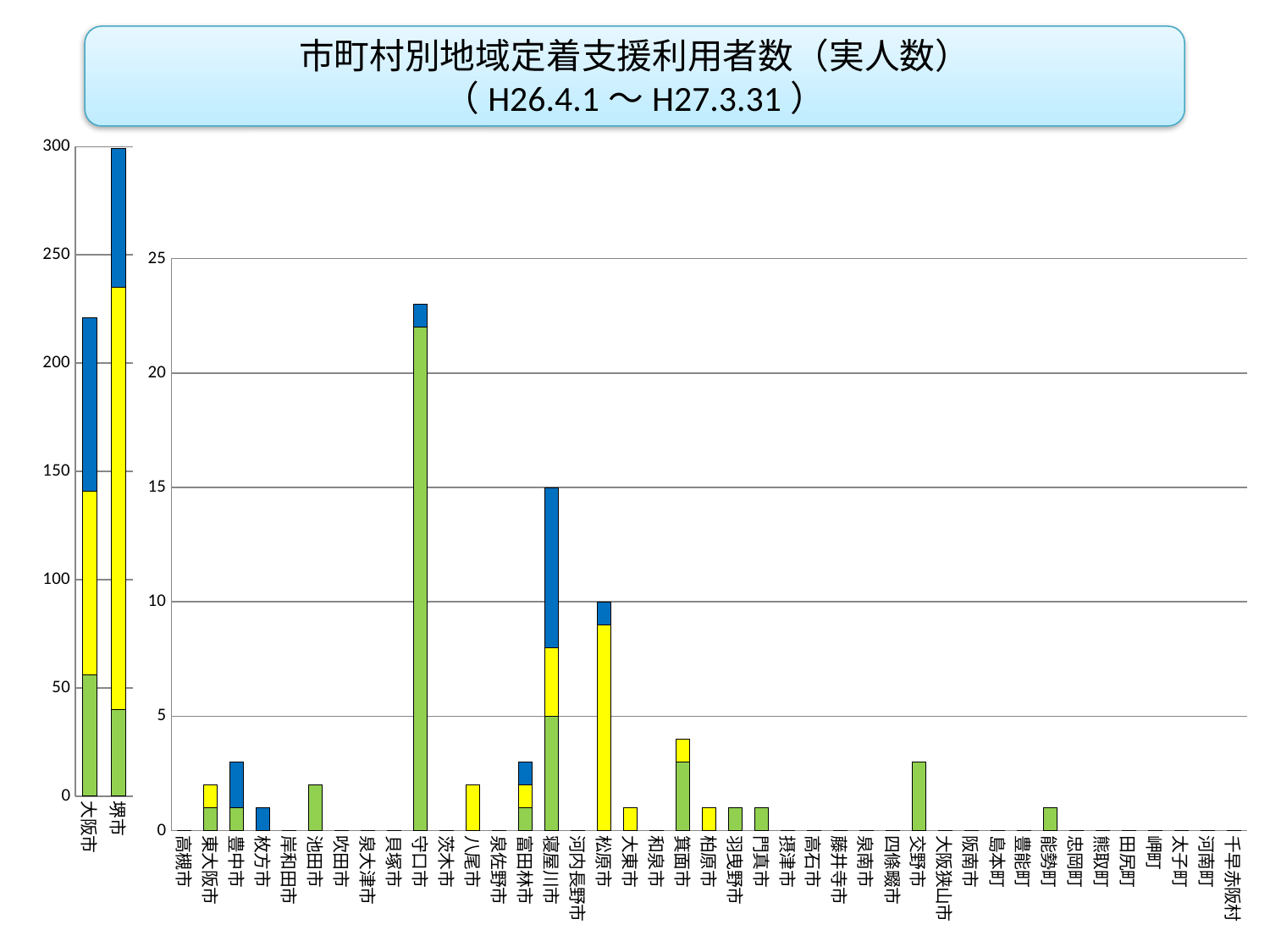
In the right chart, which has the larger total, 守口市 or 寝屋川市? 守口市 What is the title of the slide's chart? 市町村別地域定着支援利用者数（実人数）（H26.4.1 ～ H27.3.31） What kind of chart is used on this slide? stacked bar chart How many municipalities are listed on the x axis of the right chart? 41 How many cities are shown in the left chart? 2 In the left chart, is the total for 大阪市 greater or less than 200? greater In the right chart (高槻市 to 千早赤阪村), which municipality has the highest total? 守口市 In the left chart (大阪市 and 堺市), which city has the higher total? 堺市 In the right chart, is the total for 守口市 greater or less than 20? greater In the left chart, is the total for 堺市 greater or less than 250? greater